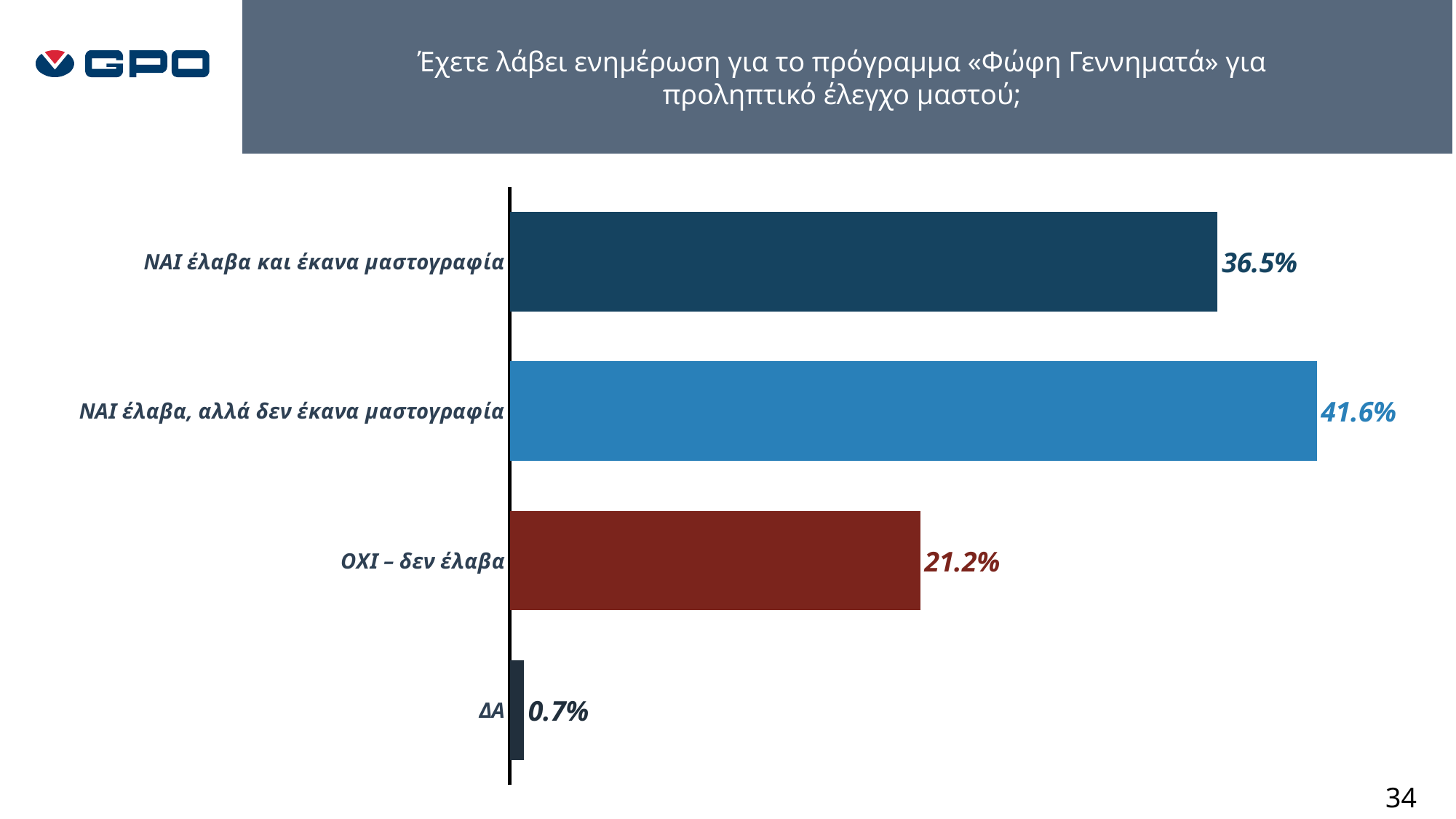
What is the value for "ΟΧΙ – δεν έλαβα"? 21.2% What is the difference between "ΝΑΙ έλαβα και έκανα μαστογραφία" and "ΟΧΙ – δεν έλαβα"? 15.3% Which category has the lowest value? ΔΑ What kind of chart is shown on the slide? Bar chart What colour is the bar for "ΟΧΙ – δεν έλαβα"? Dark red How many categories are shown in the chart? 4 Which category has the highest value? ΝΑΙ έλαβα, αλλά δεν έκανα μαστογραφία What is the value for "ΔΑ"? 0.7% What is the value for "ΝΑΙ έλαβα, αλλά δεν έκανα μαστογραφία"? 41.6% What is the value for "ΝΑΙ έλαβα και έκανα μαστογραφία"? 36.5% What is the difference between "ΝΑΙ έλαβα, αλλά δεν έκανα μαστογραφία" and "ΝΑΙ έλαβα και έκανα μαστογραφία"? 5.1% Which is larger: "ΟΧΙ – δεν έλαβα" or "ΝΑΙ έλαβα και έκανα μαστογραφία"? ΝΑΙ έλαβα και έκανα μαστογραφία